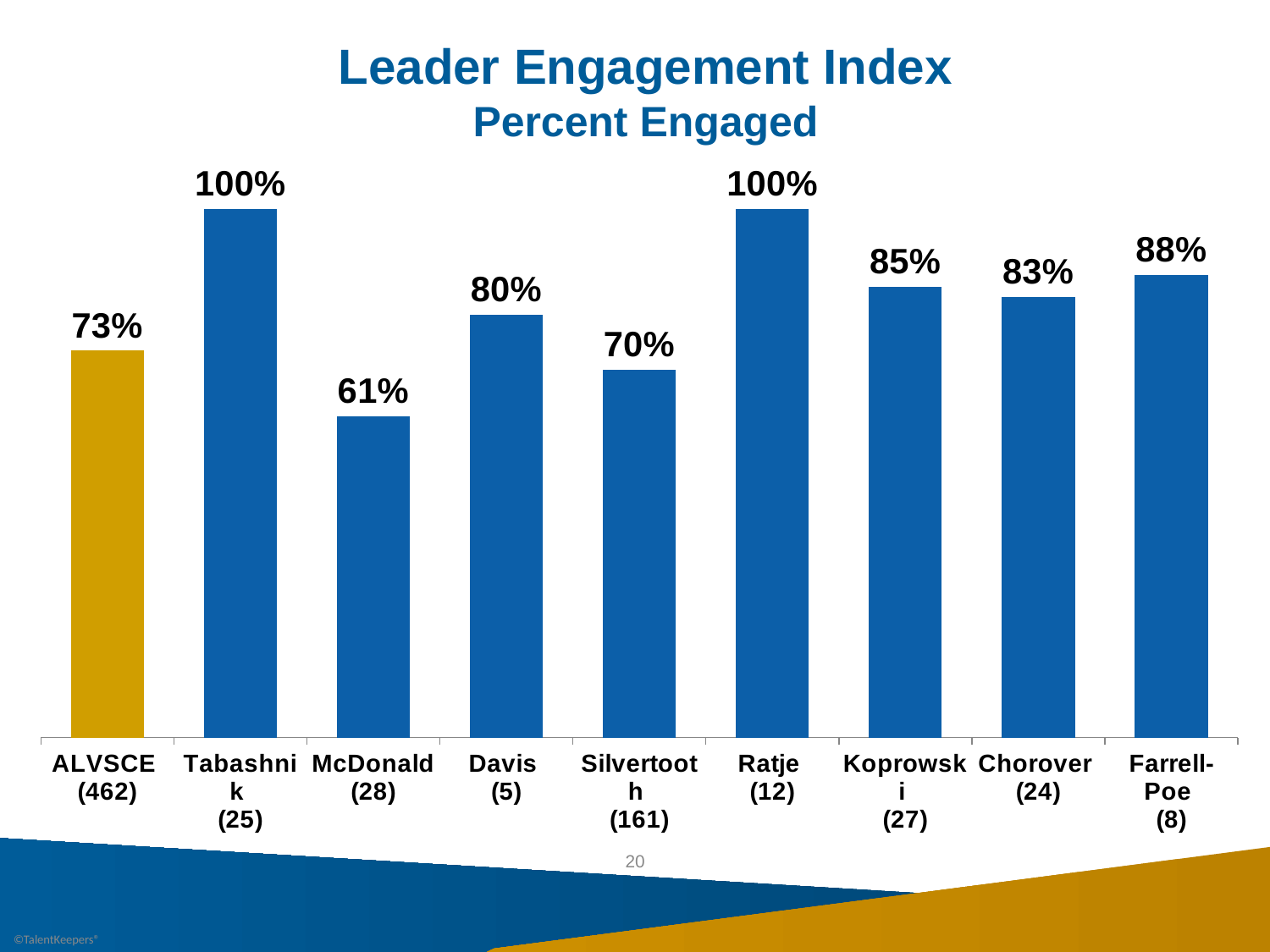
What is the percent engaged for Silvertooth (161)? 70% What is the percent engaged for ALVSCE (462)? 73% What kind of chart is shown on the slide? Bar chart What is the difference in percent engaged between Davis (5) and ALVSCE (462)? 7% Which has a higher percent engaged, Davis (5) or Silvertooth (161)? Davis (5) What is the difference in percent engaged between Koprowski (27) and Chorover (24)? 2% What is the percent engaged for McDonald (28)? 61% Which bar is shown in a different colour (gold) from the others? ALVSCE (462) Which category has the lowest percent engaged? McDonald (28) What is the percent engaged for Farrell-Poe (8)? 88% Which categories share the highest percent engaged? Tabashnik (25) and Ratje (12) How many categories are shown in the chart? 9